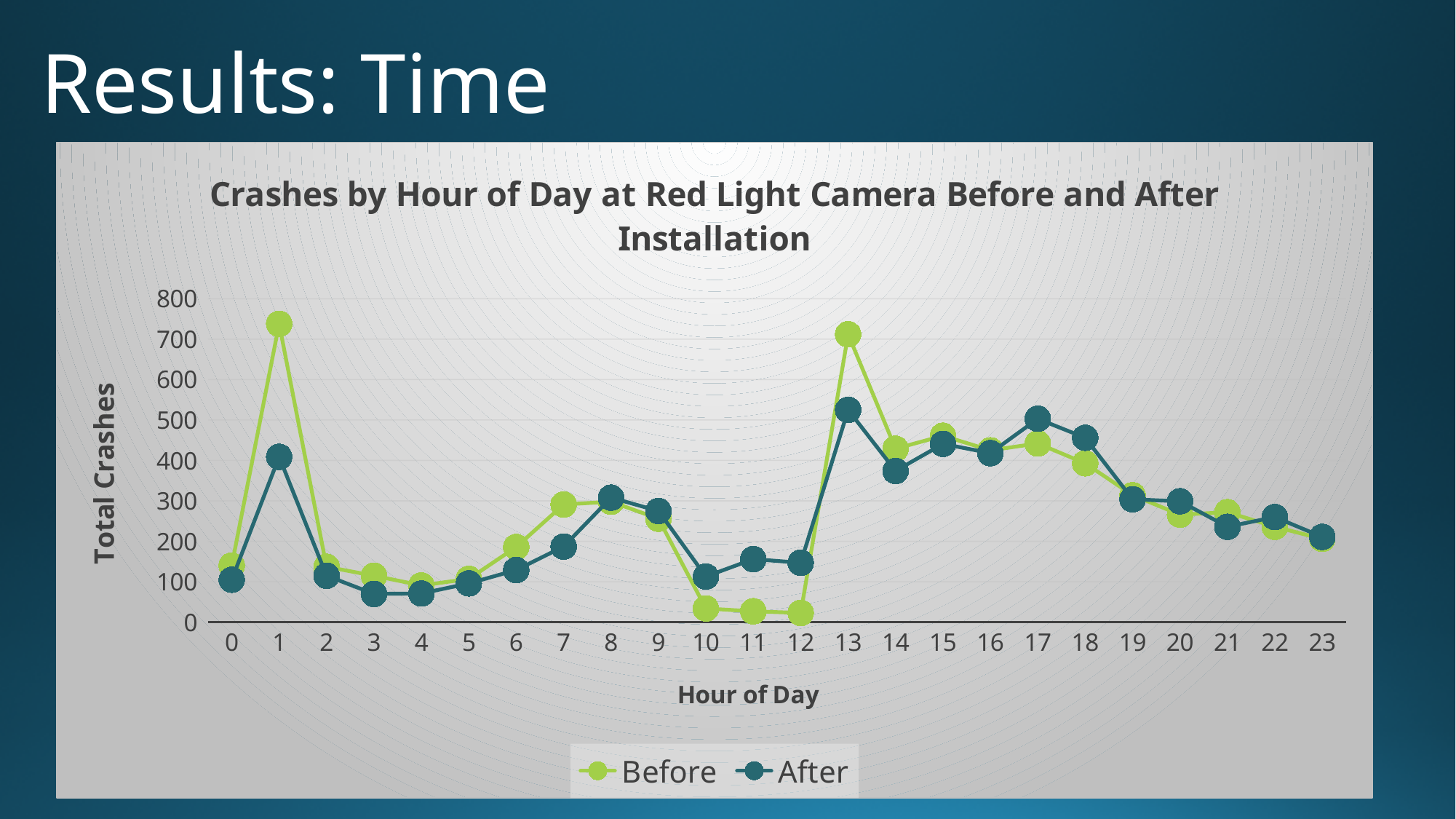
What is the title of the chart? Crashes by Hour of Day at Red Light Camera Before and After Installation At hour 11, which series has the larger value, Before or After? After At which hour of day does the Before series reach its highest value? 1 At which hour of day does the After series reach its highest value? 13 Is the Before value at hour 1 greater or less than 700? greater How many hours of the day are plotted along the x axis? 24 Is the After value at hour 13 greater or less than 400? greater Is the Before value at hour 12 greater or less than 100? less What kind of chart is shown on the slide? Line chart Does the Before series rise or fall from hour 19 to hour 23? Fall At hour 1, which series has the larger value, Before or After? Before How many series does the legend list? 2